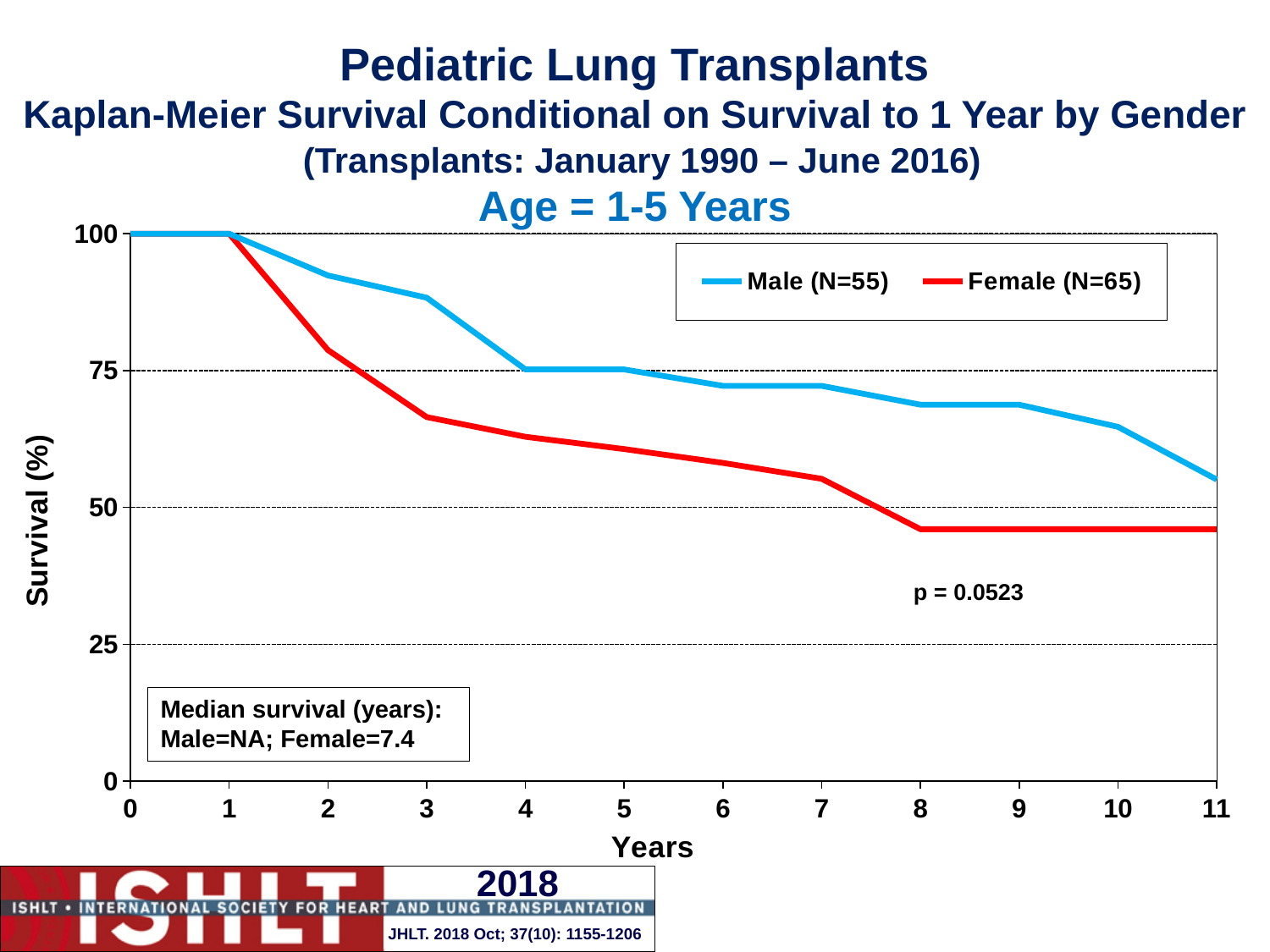
What is the survival value for Female at year 1? 100 What p-value is printed on the chart? p = 0.0523 Is the survival value for Male at year 3 greater or less than 75? greater Is the survival value for Male at year 11 greater or less than 50? greater Do the survival values rise or fall as the years increase? fall Is the survival value for Female at year 8 greater or less than 50? less What kind of chart is shown on the slide? line chart At year 5, which series has the higher survival, Male or Female? Male What is the survival value for Male at year 1? 100 How many series does the legend list? 2